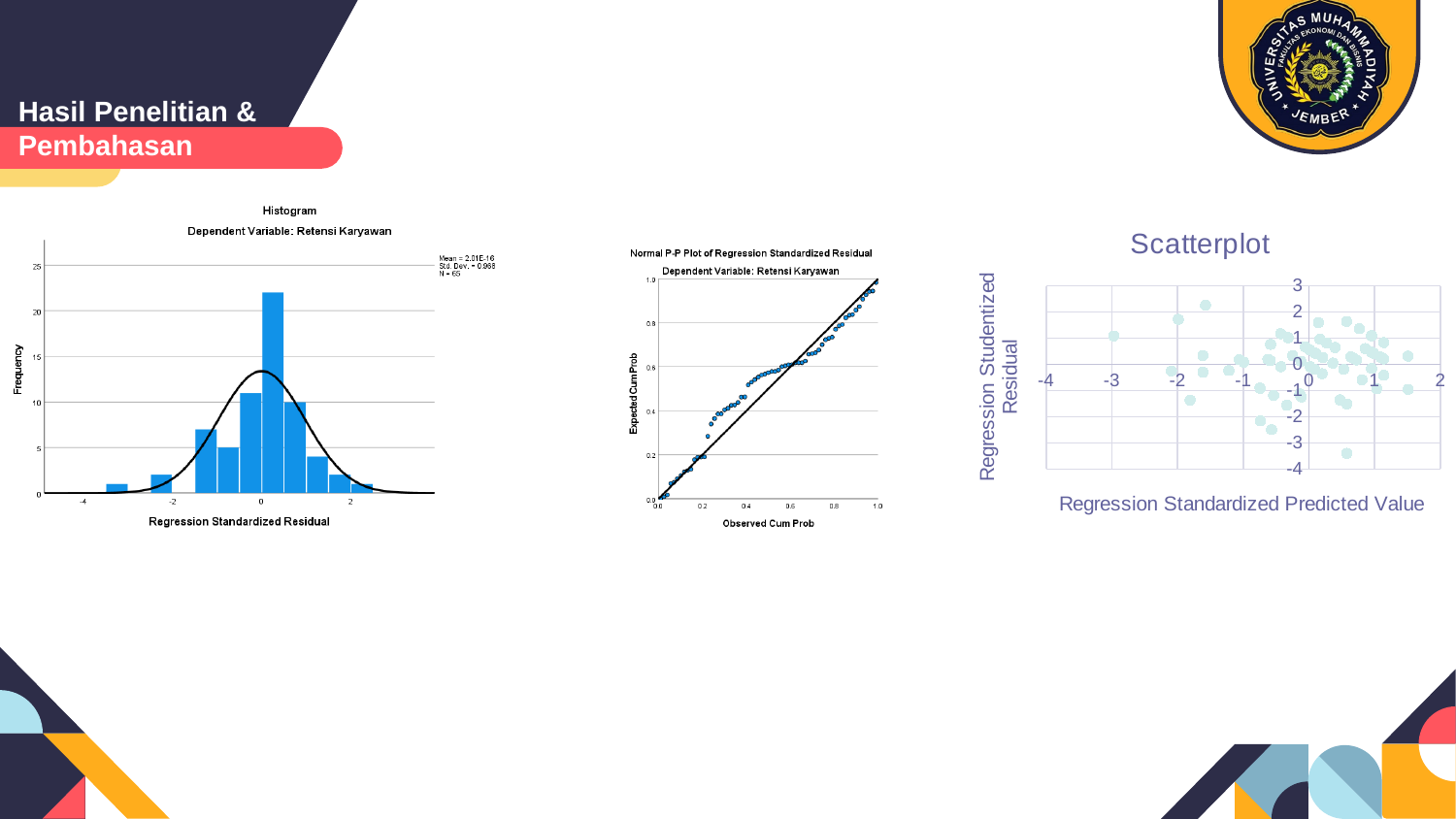
What kind of chart is the leftmost chart titled "Histogram"? bar chart What kind of chart is the rightmost chart titled "Scatterplot"? scatter plot In the Histogram chart, what is the value of N shown in the statistics text? N = 65 What is the dependent variable named in the subtitle of the Histogram chart? Retensi Karyawan What kind of chart is the middle chart, the Normal P-P Plot of Regression Standardized Residual? scatter plot In the Scatterplot chart, what is the lowest value shown on the x axis? -4 In the Histogram chart, is the frequency of the tallest bar greater or less than 20? greater In the Histogram chart, what is the Std. Dev. shown in the statistics text? 0.968 In the Histogram chart, is the frequency of the bar at -3 on the x axis greater or less than 5? less In the Normal P-P Plot chart, do the plotted points rise or fall as Observed Cum Prob increases? rise In the Histogram chart, what is the Mean shown in the statistics text? 2.01E-16 What is the x-axis label of the Scatterplot chart? Regression Standardized Predicted Value